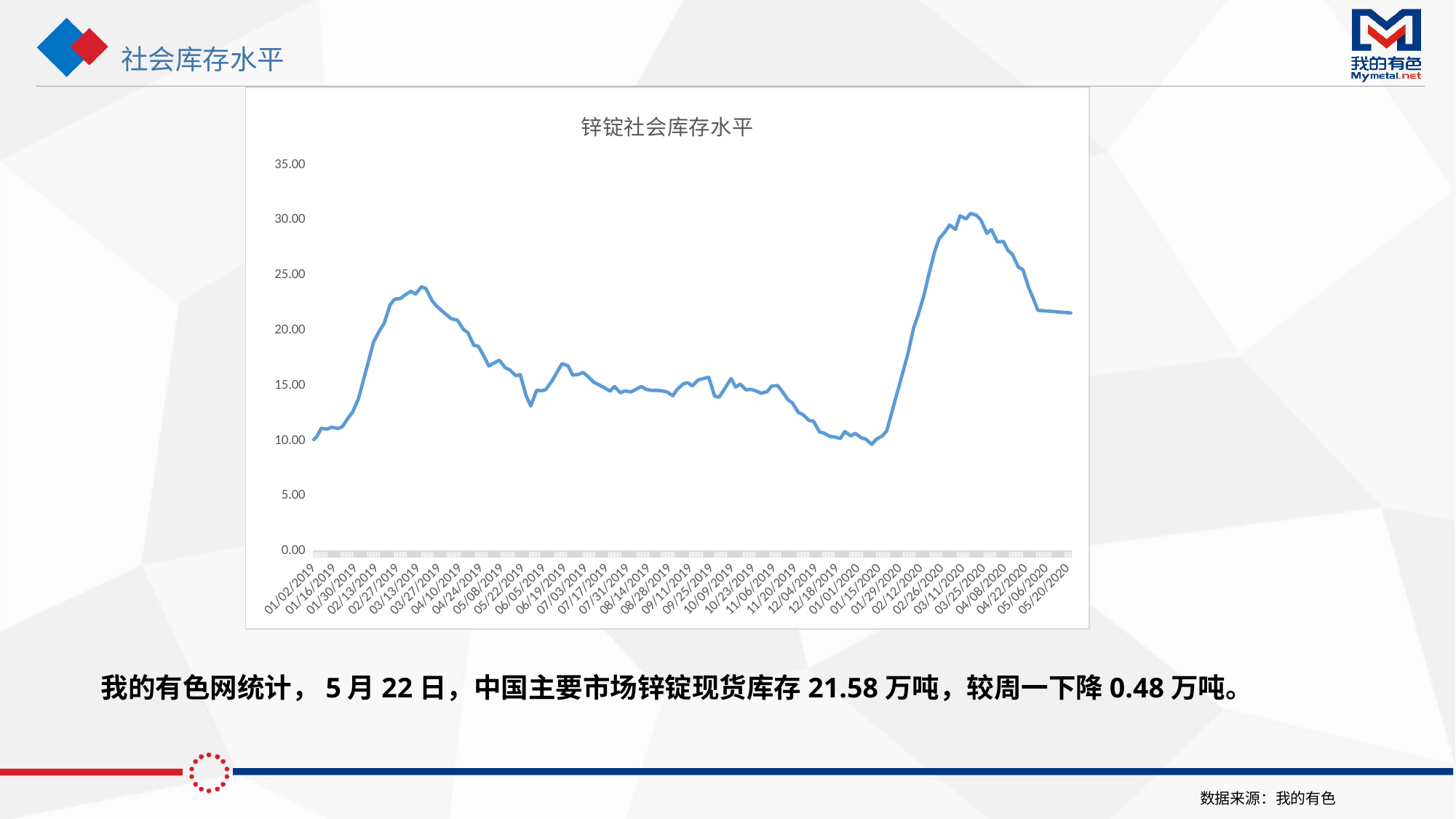
Does the line rise or fall between 01/15/2020 and 03/11/2020? rise Does the line rise or fall between 03/25/2020 and 05/06/2020? fall Is the value for 03/27/2019 greater or less than 25.00? less What is the highest value shown on the vertical axis of the chart? 35.00 What kind of chart is shown on the slide? line chart Which is higher: the value for 03/25/2020 or the value for 03/27/2019? 03/25/2020 Is the value for 03/25/2020 greater or less than 25.00? greater Is the value for 05/20/2020 greater or less than 20.00? greater What is the title of the chart? 锌锭社会库存水平